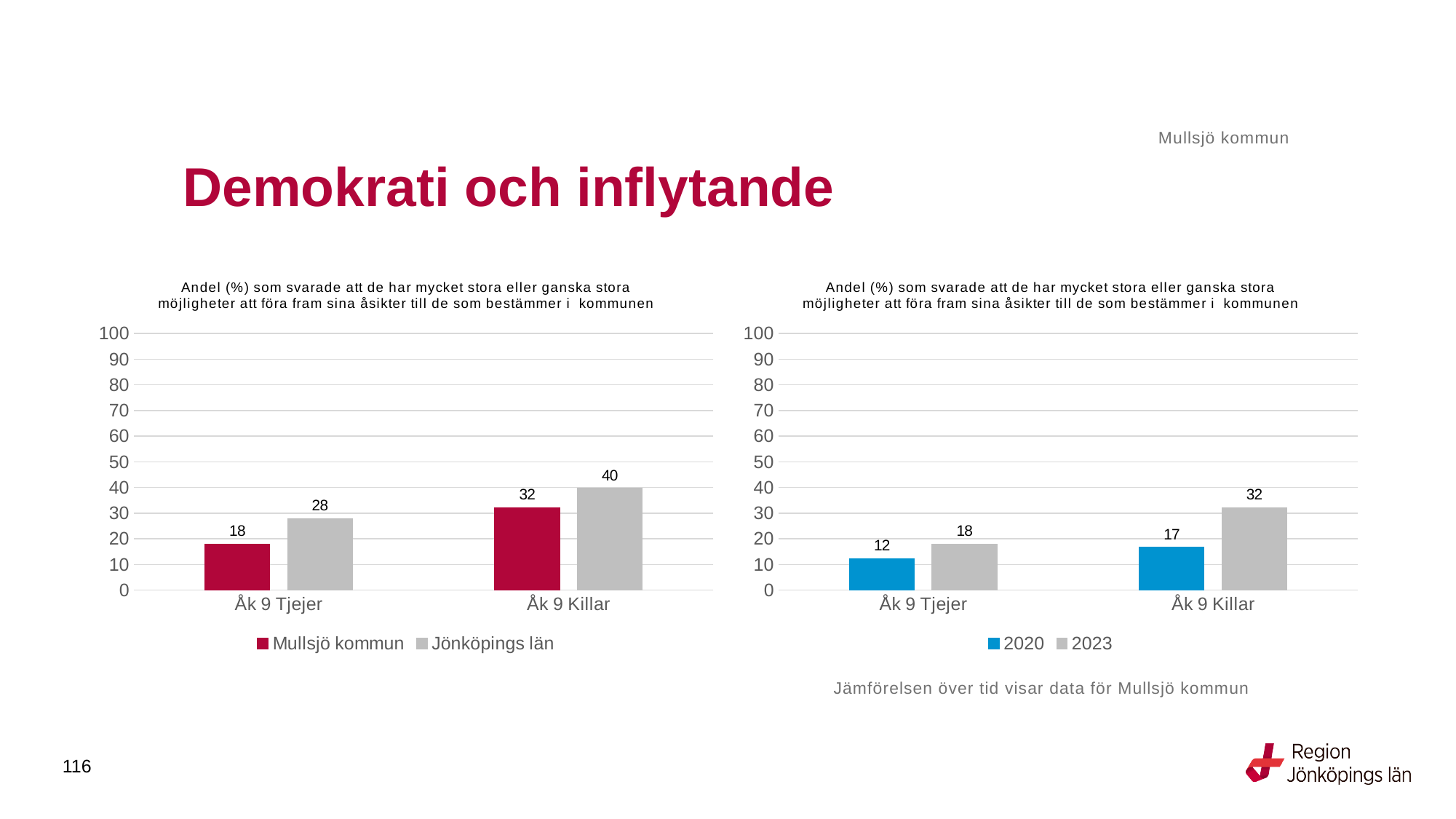
In the left chart, what is the value for Mullsjö kommun for Åk 9 Tjejer? 18 In the right chart, what is the value for 2020 for Åk 9 Tjejer? 12 In the right chart, what is the difference between 2023 and 2020 for Åk 9 Tjejer? 6 What kind of chart is the right chart? Bar chart In the left chart, what is the difference between Jönköpings län and Mullsjö kommun for Åk 9 Killar? 8 In the right chart, which bar is the highest? 2023 for Åk 9 Killar In the right chart, which series is shown in blue? 2020 How many series does the legend of the left chart list? 2 In the right chart, what is the value for 2023 for Åk 9 Killar? 32 In the left chart, which is larger for Åk 9 Tjejer: Mullsjö kommun or Jönköpings län? Jönköpings län In the left chart, what is the value for Jönköpings län for Åk 9 Killar? 40 In the right chart, which bar is the lowest? 2020 for Åk 9 Tjejer